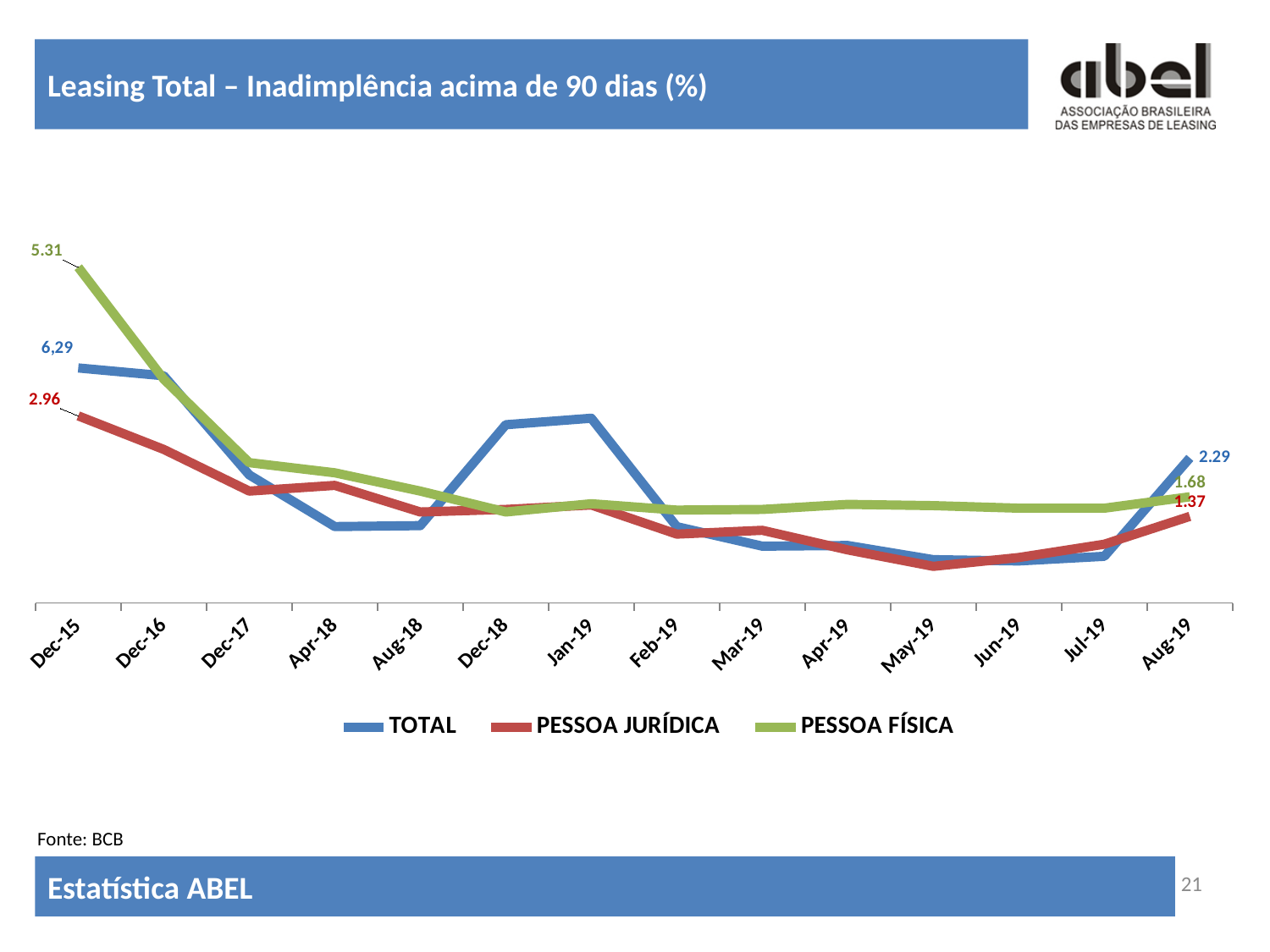
What is the value of PESSOA JURÍDICA at Dec-15? 2.96 Which series has the highest value at Aug-19? TOTAL How many dates are shown on the x axis? 14 How many series does the legend list? 3 What is the value of TOTAL at Aug-19? 2.29 What is the value of PESSOA JURÍDICA at Aug-19? 1.37 What kind of chart is shown on the slide? Line chart What is the value of PESSOA FÍSICA at Aug-19? 1.68 What is the difference between TOTAL and PESSOA JURÍDICA at Aug-19? 0.92 At Dec-15, which is larger: PESSOA FÍSICA or PESSOA JURÍDICA? PESSOA FÍSICA Which series has the lowest value at Aug-19? PESSOA JURÍDICA What is the value of PESSOA FÍSICA at Dec-15? 5.31